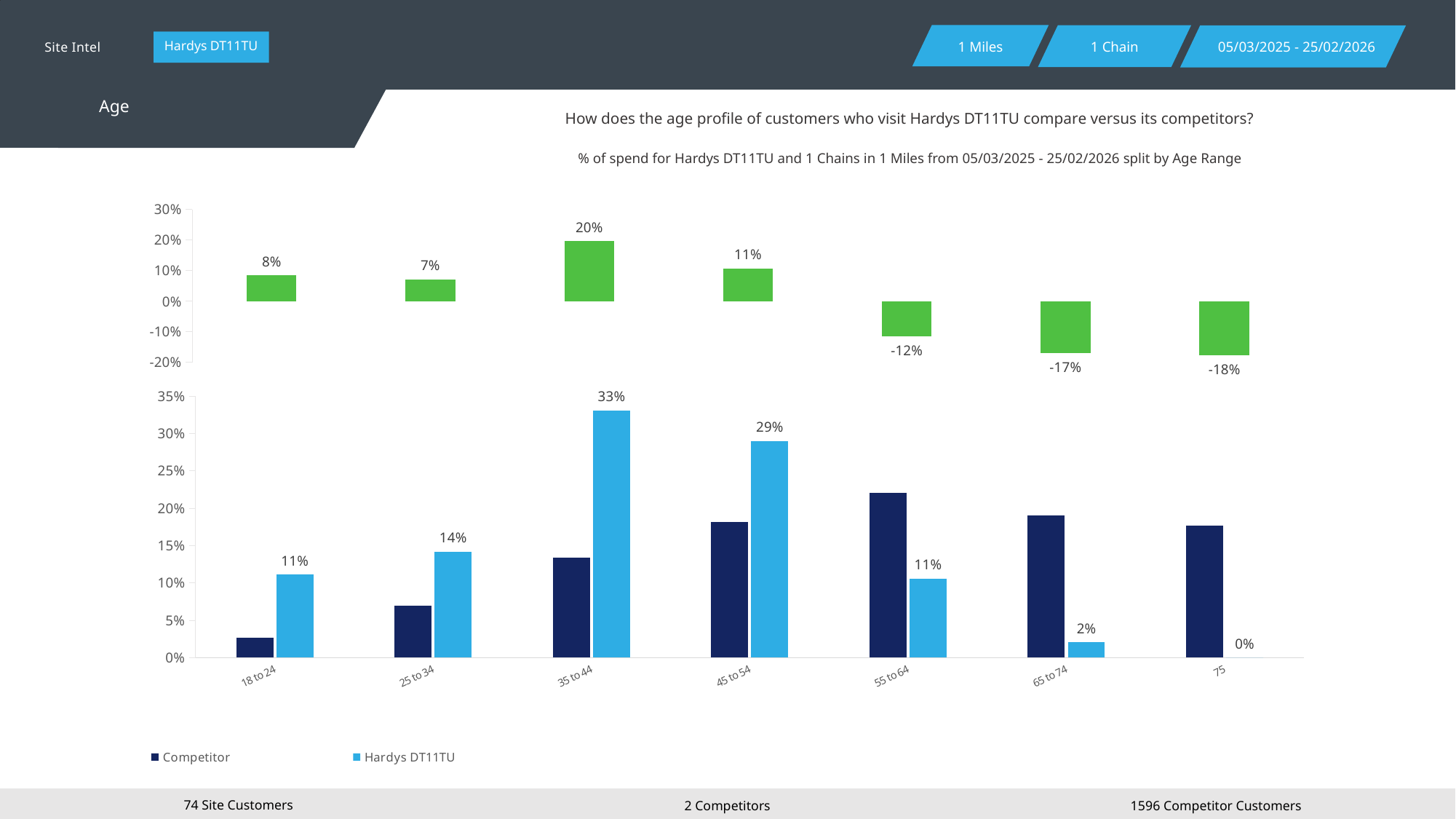
In the bottom chart, what is the difference between the Hardys DT11TU values for 35 to 44 and 45 to 54? 4% In the bottom chart, what is the value for Hardys DT11TU in the 65 to 74 age range? 2% In the top green chart, what is the value of the third bar from the left? 20% In the bottom chart, which age range has the highest value for Hardys DT11TU? 35 to 44 How many series does the legend of the bottom chart list? 2 In the bottom chart, is the Competitor value for 55 to 64 greater or less than 20%? greater How many age range categories are shown on the x axis of the bottom chart? 7 In the bottom chart, which age range has the lowest value for Hardys DT11TU? 75 In the bottom chart, what is the value for Hardys DT11TU in the 35 to 44 age range? 33% In the bottom chart, for the 55 to 64 age range, which series has the larger value, Competitor or Hardys DT11TU? Competitor In the bottom chart, is the Competitor value for 18 to 24 greater or less than 5%? less What kind of chart is the bottom chart? bar chart